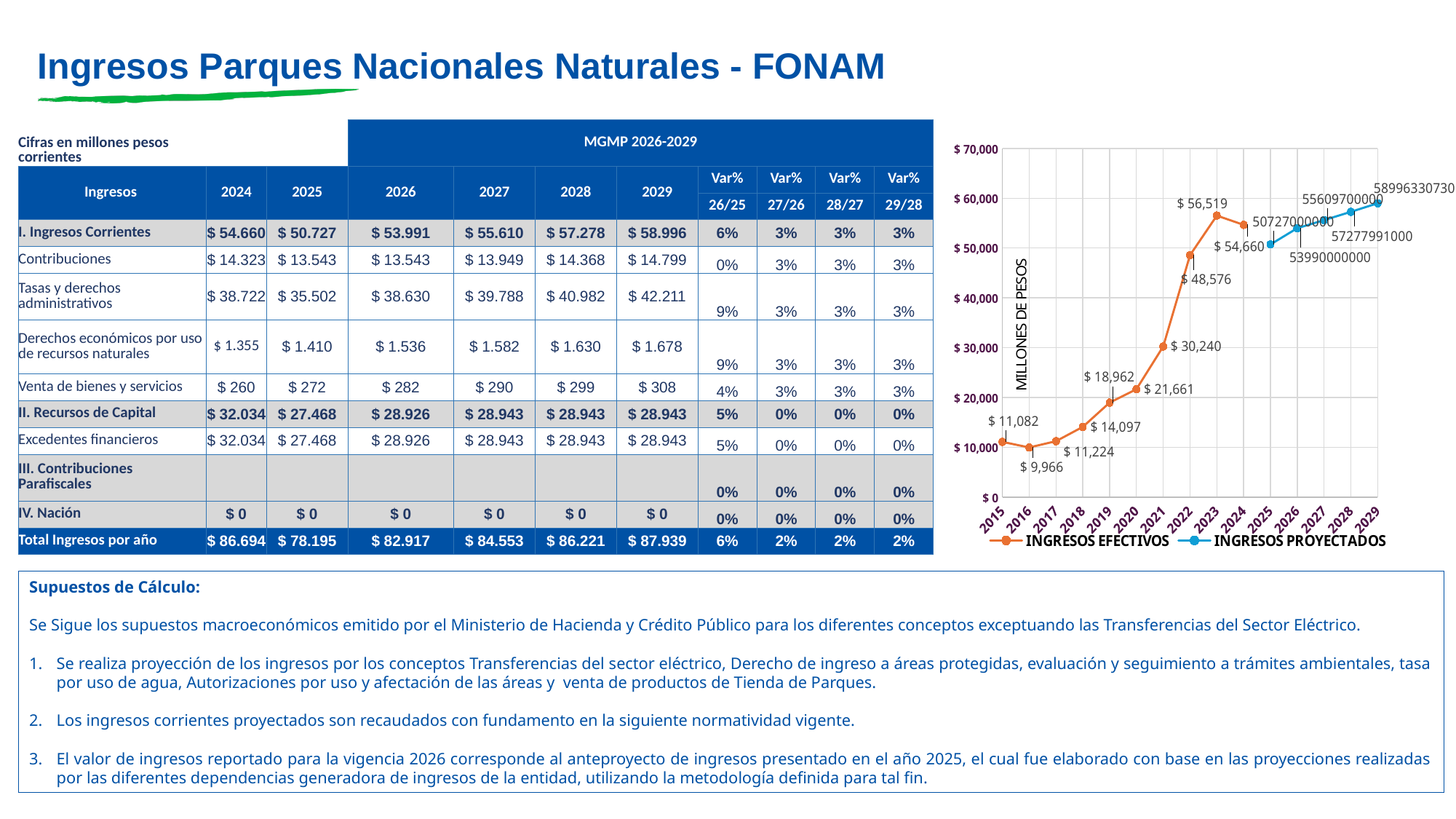
How many years are shown on the x axis of the line chart? 15 Which year has the highest value on the line chart? 2029 What is the value labelled for 2021 on the line chart? $ 30,240 On the line chart, which year has the larger value, 2021 or 2022? 2022 What is the value labelled for 2016 on the line chart? $ 9,966 What is the value labelled for 2023 on the line chart? $ 56,519 On the line chart, what is the difference between the 2023 value and the 2024 value? $ 1,859 Which year has the lowest value on the line chart? 2016 What are the two series named in the legend of the line chart? INGRESOS EFECTIVOS and INGRESOS PROYECTADOS What kind of chart is shown on the right side of the slide? line chart How many series does the legend of the line chart list? 2 Is the value for 2025 on the line chart greater or less than $ 50,000? greater